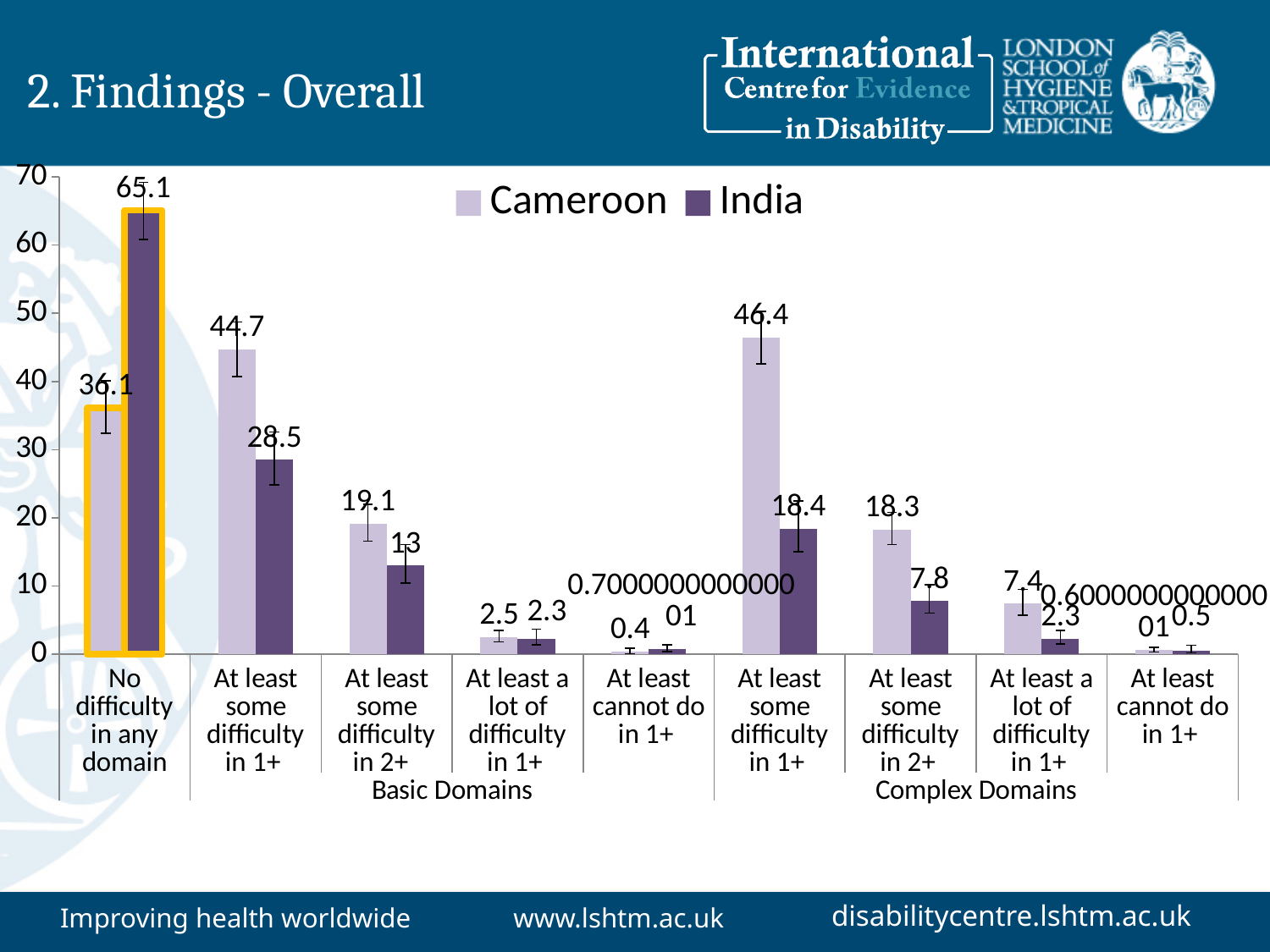
Which category is highlighted with a yellow box on the chart? No difficulty in any domain For 'At least some difficulty in 2+' under Basic Domains, which is larger, Cameroon or India? Cameroon Which category has the highest Cameroon value? At least some difficulty in 1+ (Complex Domains) What is the value for India in the 'No difficulty in any domain' category? 65.1 What is the value for India for 'At least some difficulty in 2+' under Complex Domains? 7.8 Which series has the tallest bar on the chart? India What kind of chart is shown on the slide? Bar chart What is the difference between the Cameroon and India values for 'At least some difficulty in 1+' under Complex Domains? 28 How many series does the legend list? 2 What is the difference between the India and Cameroon values for 'No difficulty in any domain'? 29 What is the value for Cameroon for 'At least a lot of difficulty in 1+' under Complex Domains? 7.4 What is the value for Cameroon for 'At least some difficulty in 1+' under Basic Domains? 44.7